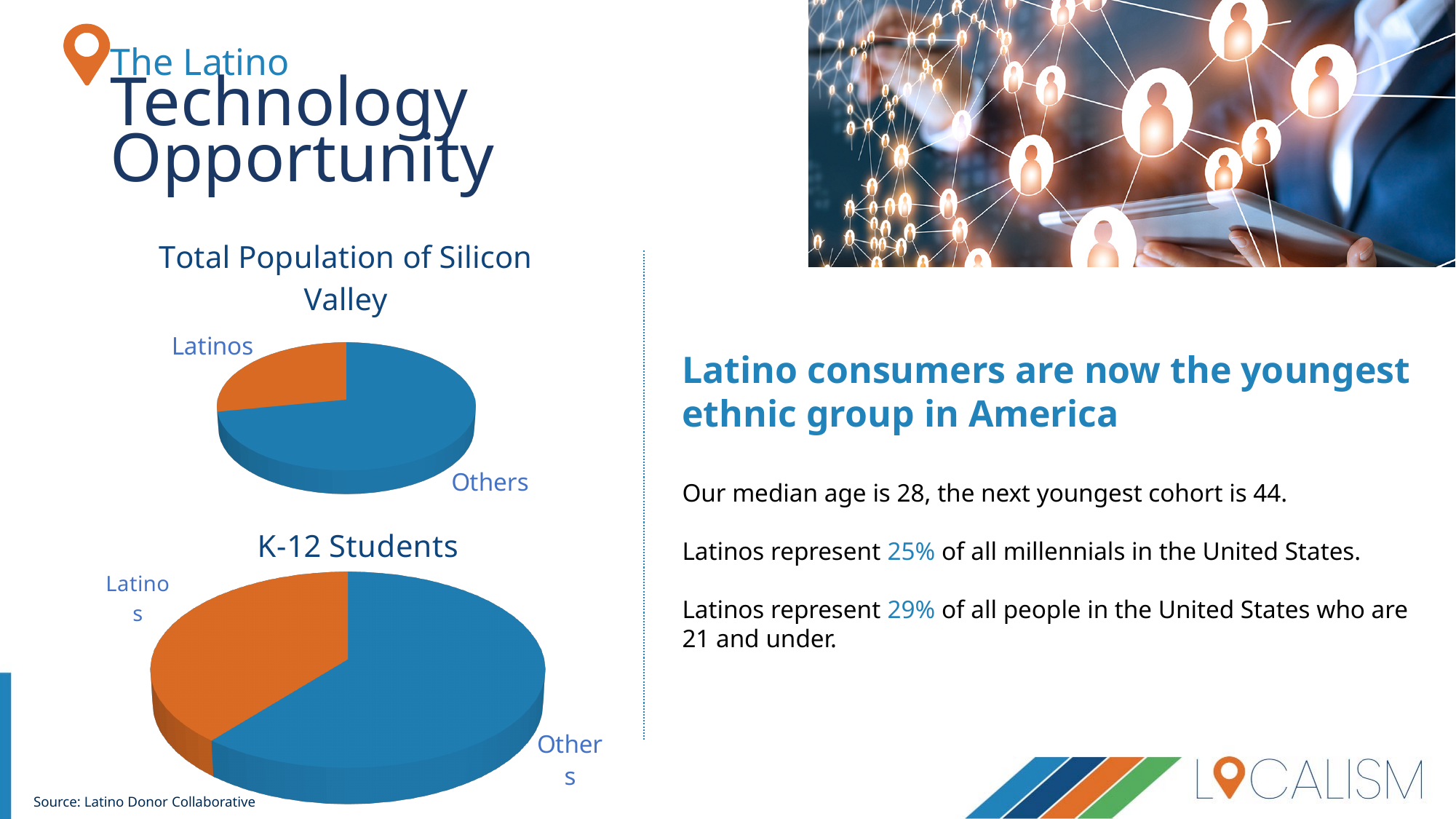
How many slices does the "Total Population of Silicon Valley" pie chart have? 2 What is the title of the upper pie chart on the slide? Total Population of Silicon Valley In the "K-12 Students" chart, which slice is the largest? Others How many slices does the "K-12 Students" pie chart have? 2 In the "Total Population of Silicon Valley" chart, which slice is the largest? Others In the "Total Population of Silicon Valley" chart, which slice is the smallest? Latinos In the "K-12 Students" chart, is the Latinos slice larger or smaller than the Others slice? smaller In the "K-12 Students" chart, which slice is the smallest? Latinos In the "Total Population of Silicon Valley" chart, is the Others slice larger or smaller than the Latinos slice? larger What colour is the Latinos slice in the "K-12 Students" chart? orange What kind of chart is the "K-12 Students" chart? pie chart What kind of chart is the "Total Population of Silicon Valley" chart? pie chart